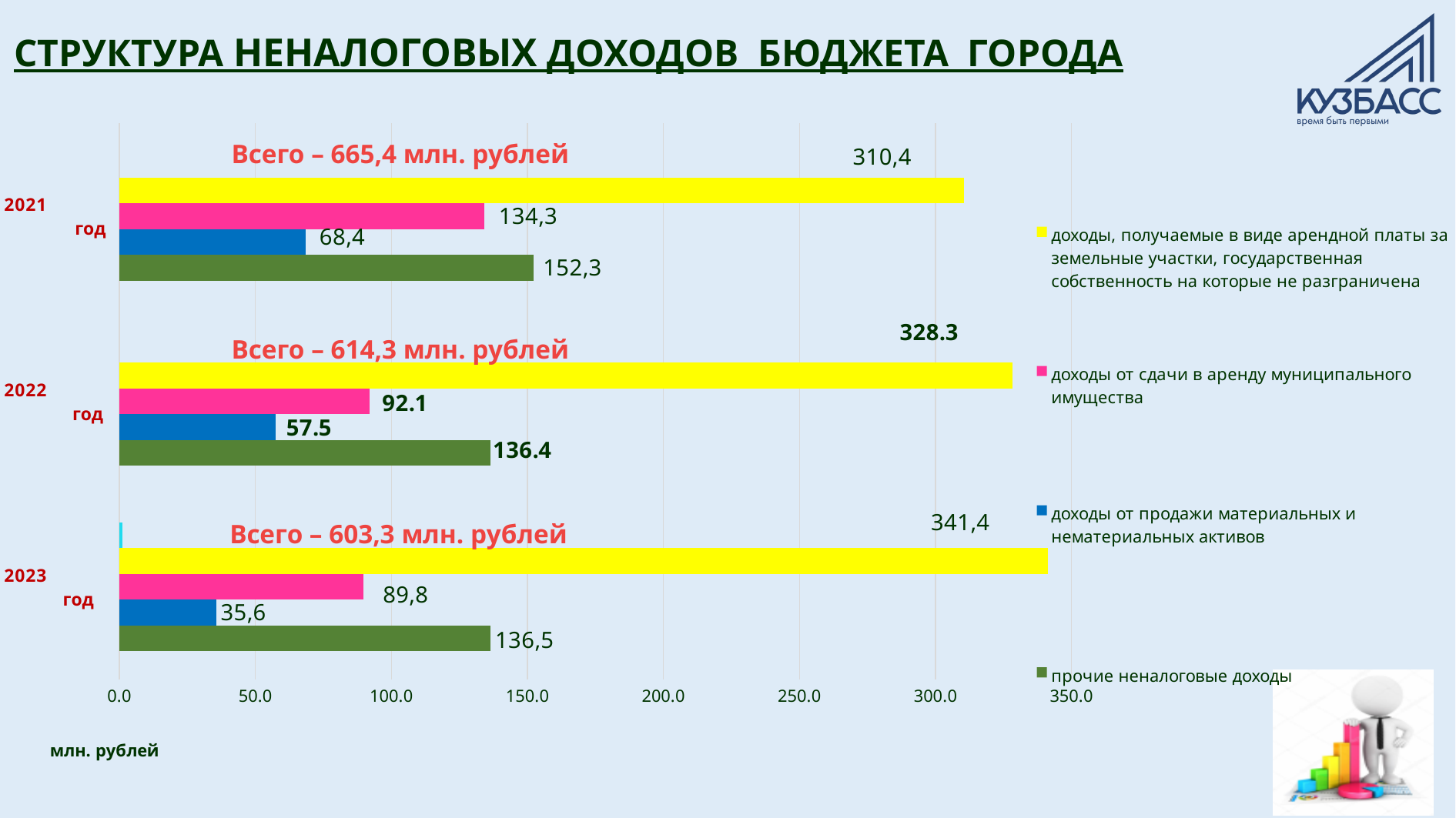
In 2021, which is larger: прочие неналоговые доходы or доходы от сдачи в аренду муниципального имущества? прочие неналоговые доходы Which series has the lowest value in 2022? доходы от продажи материальных и нематериальных активов What kind of chart is shown on the slide? bar chart Is the value for доходы от сдачи в аренду муниципального имущества in 2023 greater or less than 100.0? less What is the value for доходы от продажи материальных и нематериальных активов in 2023? 35,6 Does the value for доходы от продажи материальных и нематериальных активов rise or fall from 2021 to 2023? fall What is the value for прочие неналоговые доходы in 2022? 136.4 Which series has the highest value in 2023? доходы, получаемые в виде арендной платы за земельные участки, государственная собственность на которые не разграничена How many years are shown on the chart? 3 How many series does the legend list? 4 What is the difference between the land rent income in 2023 and in 2021? 31,0 What is the value for доходы, получаемые в виде арендной платы за земельные участки in 2021? 310,4